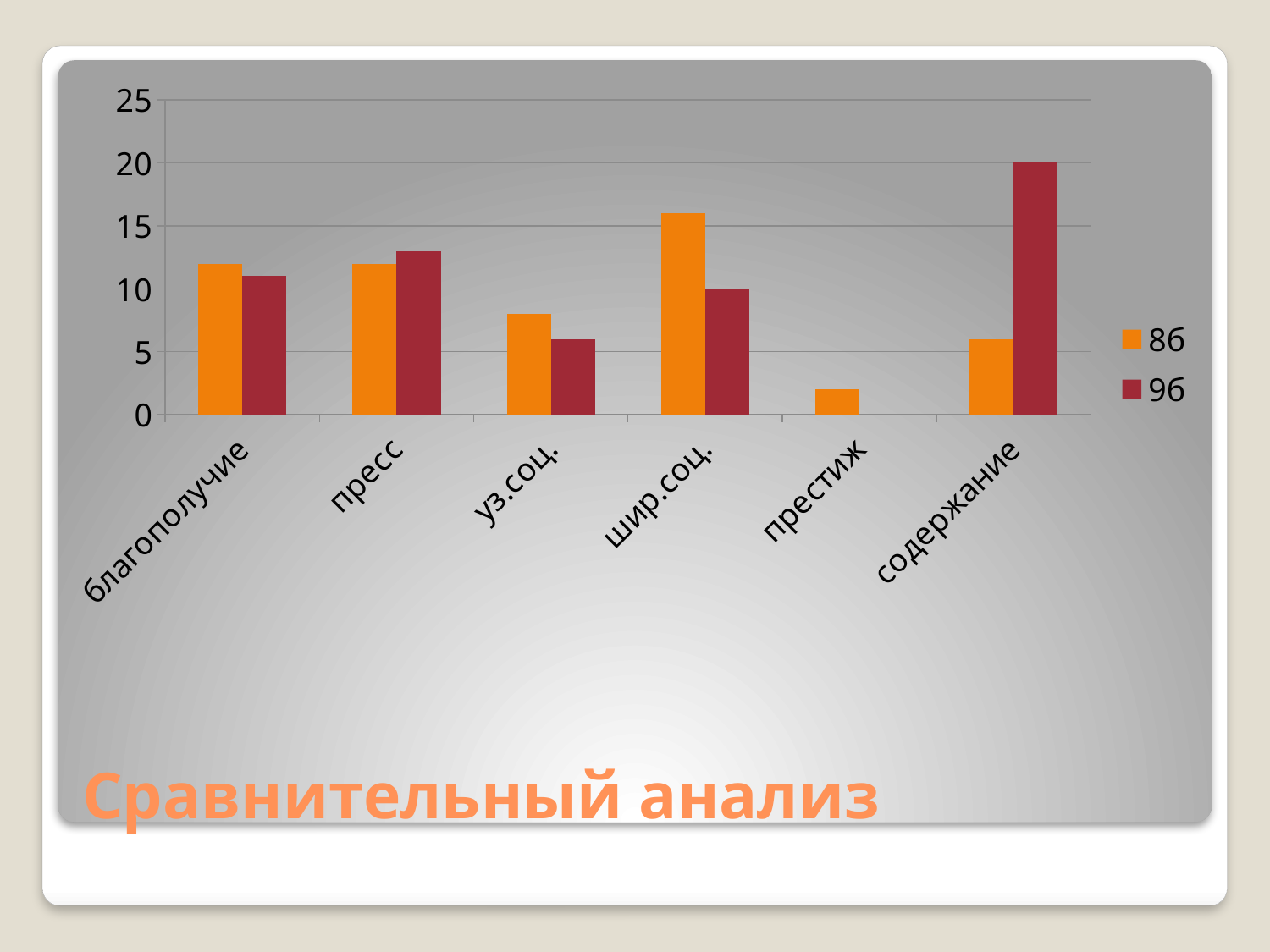
What is the value for 9б in the шир.соц. category? 10 In the шир.соц. category, which series has the larger value, 8б or 9б? 8б How many series does the legend list? 2 In the содержание category, which series has the larger value, 8б or 9б? 9б What is the title of the chart? Сравнительный анализ How many categories are shown on the x axis? 6 What is the value for 9б in the содержание category? 20 Is the value for 8б in the шир.соц. category greater or less than 15? greater Which category has the highest value for the 8б series? шир.соц. What kind of chart is shown on the slide? bar chart Which category has the lowest value for the 8б series? престиж Which category has the highest value for the 9б series? содержание